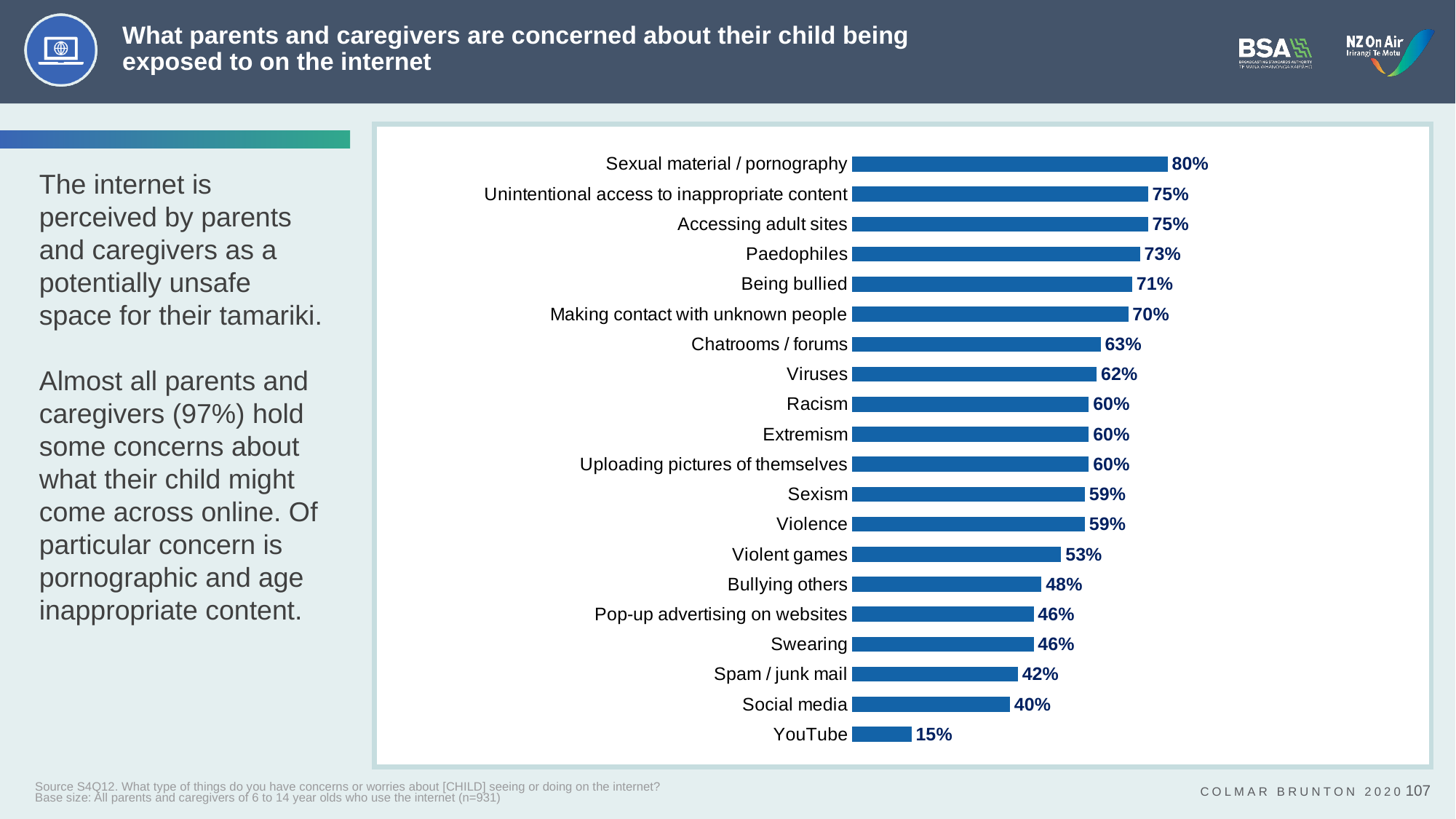
What is the difference between the values for Being bullied and Bullying others? 23 percentage points What percentage of parents and caregivers are concerned about their child being exposed to sexual material / pornography? 80% Which concern has the highest percentage? Sexual material / pornography Which has a higher value, Chatrooms / forums or Violent games? Chatrooms / forums What percentage is shown for Social media? 40% What is the value shown for Making contact with unknown people? 70% What is the value shown for Viruses? 62% What kind of chart is shown on the slide? Bar chart Which concern has the lowest percentage? YouTube How many concern categories are shown in the chart? 20 Which has a higher value, Spam / junk mail or Paedophiles? Paedophiles What is the difference between the values for Sexual material / pornography and YouTube? 65 percentage points